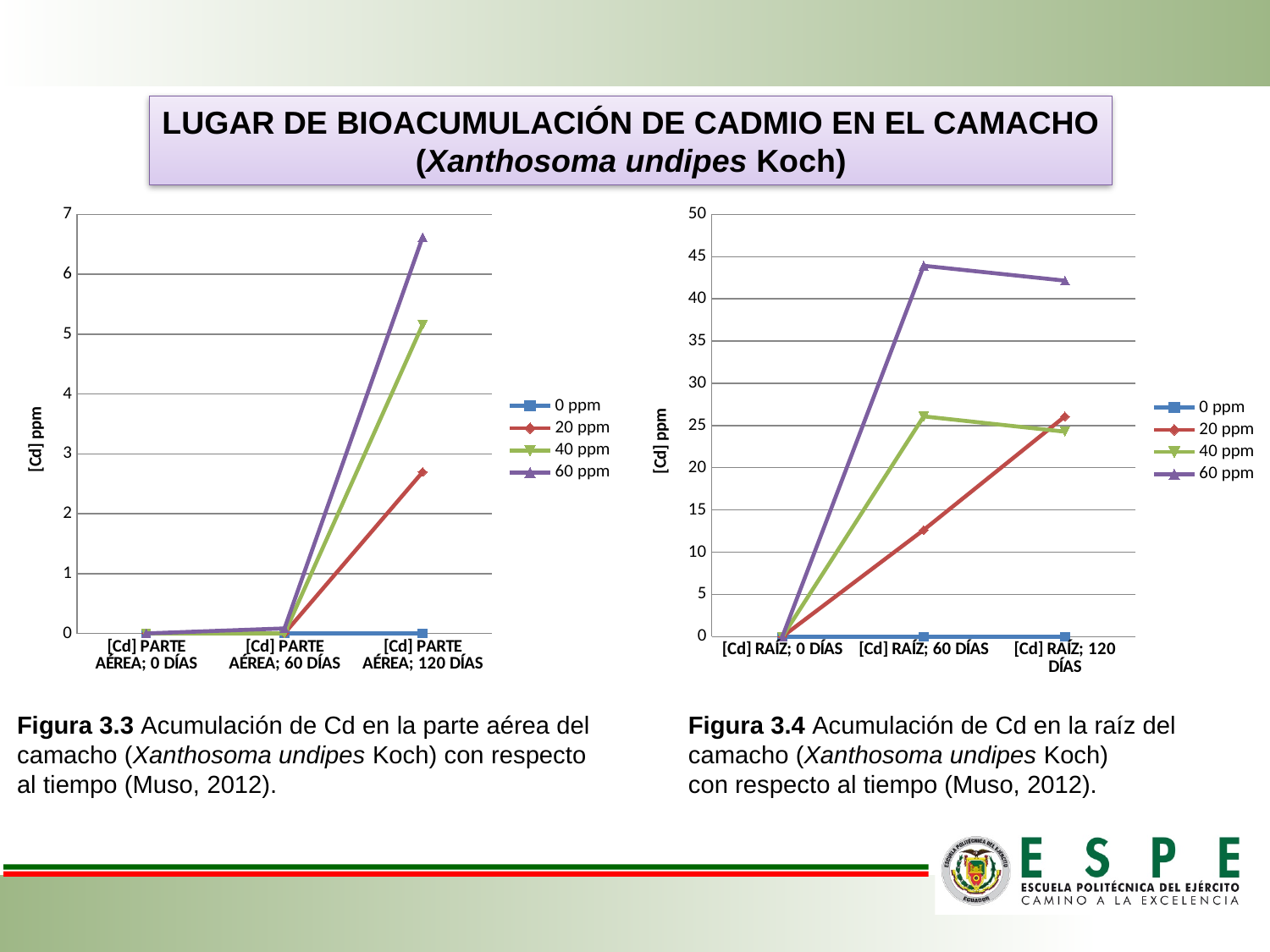
In the right chart (Figura 3.4), is the value of the 60 ppm series at 60 días greater or less than 40? greater What kind of chart is the left chart (Figura 3.3)? line chart In the right chart (Figura 3.4), which series has the lowest values across all time points? 0 ppm In the left chart (Figura 3.3), is the value of the 20 ppm series at 120 días greater or less than 3? less In the left chart (Figura 3.3), which series has the highest value at 120 días? 60 ppm How many series does the legend of the right chart (Figura 3.4) list? 4 In the left chart (Figura 3.3), is the value of the 60 ppm series at 120 días greater or less than 6? greater In the right chart (Figura 3.4), does the 20 ppm series rise or fall from 0 días to 120 días? rise How many time points are plotted along the x axis of the left chart (Figura 3.3)? 3 In the right chart (Figura 3.4), which is larger at 60 días: the 40 ppm series or the 20 ppm series? 40 ppm What is the label of the y axis on the left chart (Figura 3.3)? [Cd] ppm